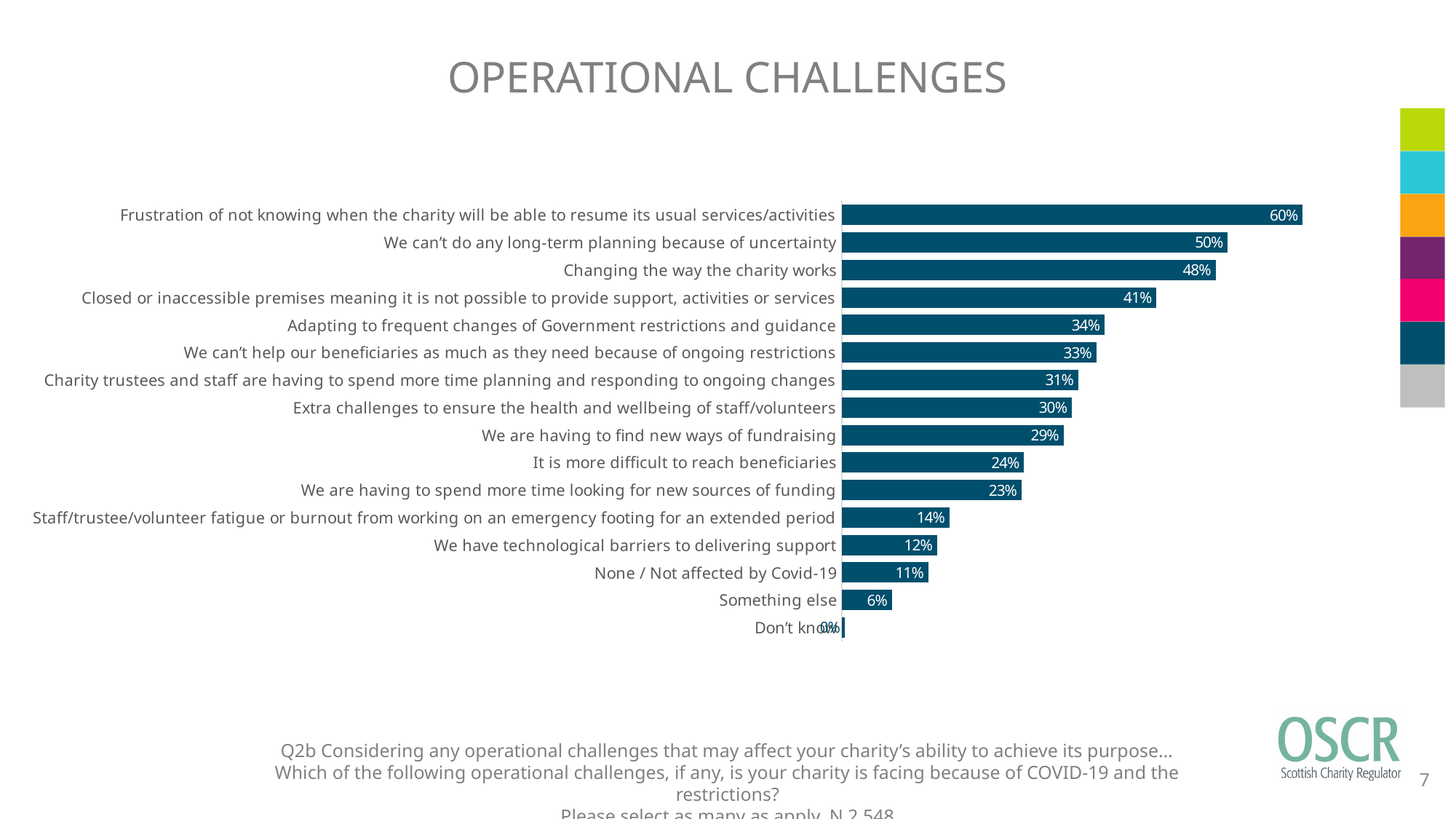
How many categories are shown on the chart? 16 Which category has the lowest value on the chart? Don't know What is the difference between the highest value and 'Closed or inaccessible premises meaning it is not possible to provide support, activities or services'? 19% What is the title of the chart on the slide? OPERATIONAL CHALLENGES What is the value for 'Something else'? 6% What percentage selected 'None / Not affected by Covid-19'? 11% What type of chart is shown on the slide? Bar chart What is the value for 'We have technological barriers to delivering support'? 12% What is the difference between 'We can't do any long-term planning because of uncertainty' and 'Adapting to frequent changes of Government restrictions and guidance'? 16% Which operational challenge has the highest percentage? Frustration of not knowing when the charity will be able to resume its usual services/activities What percentage of charities reported 'Changing the way the charity works' as an operational challenge? 48% Which is larger: 'It is more difficult to reach beneficiaries' or 'We are having to find new ways of fundraising'? We are having to find new ways of fundraising